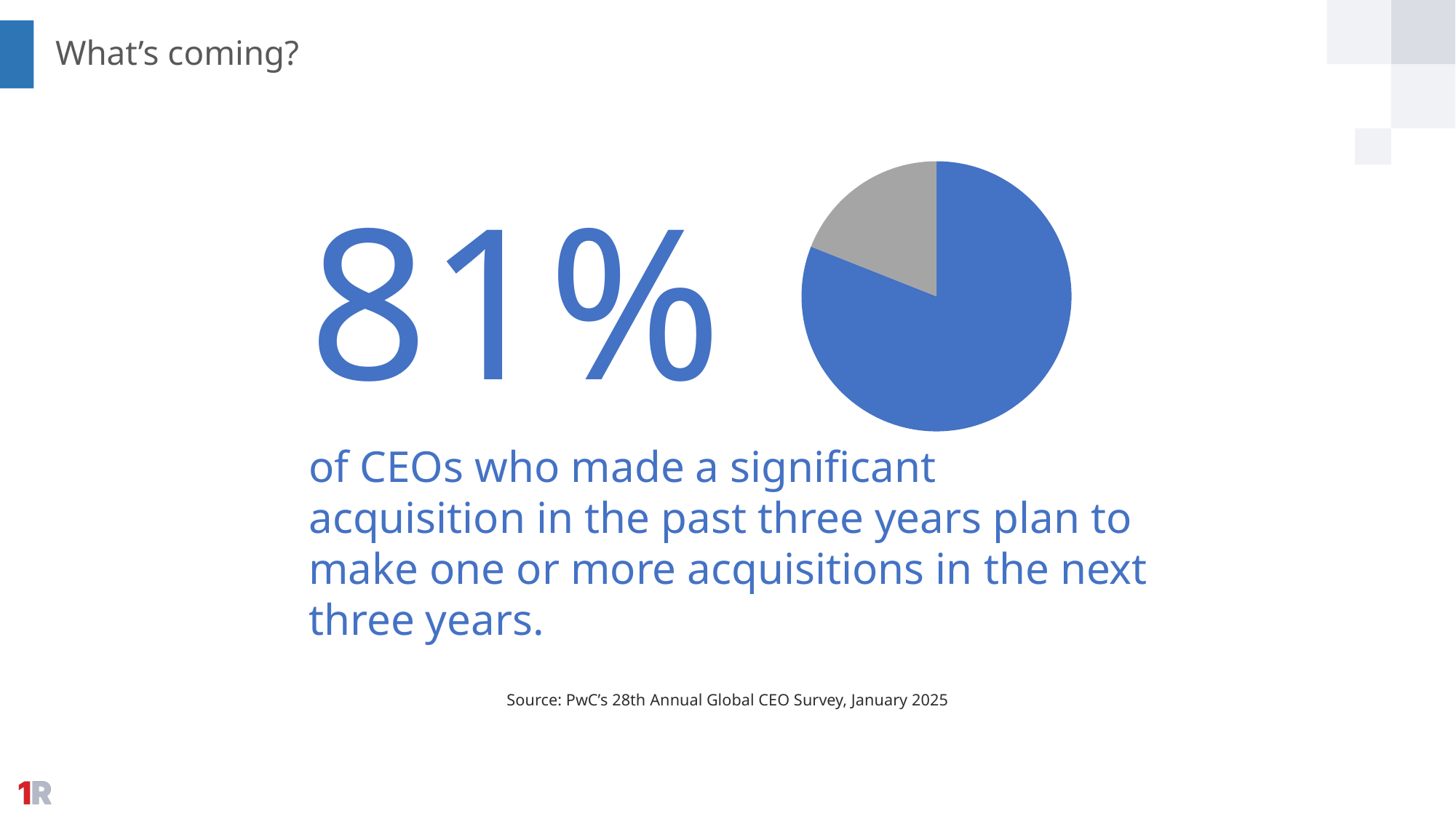
What percentage of CEOs who made a significant acquisition in the past three years plan to make one or more acquisitions in the next three years? 81% Is the share of the blue slice greater or less than 50%? greater Which slice of the pie chart is the smallest? the grey slice What is the title of the slide containing the pie chart? What's coming? What share of the pie does the blue slice represent? 81% How many slices does the pie chart have? 2 Which slice of the pie chart is the largest? the blue slice Which slice of the pie chart is larger, the blue one or the grey one? blue Is the share of the grey slice greater or less than 25%? less What kind of chart is shown on the slide? pie chart What source is cited for the data in the pie chart? PwC's 28th Annual Global CEO Survey, January 2025